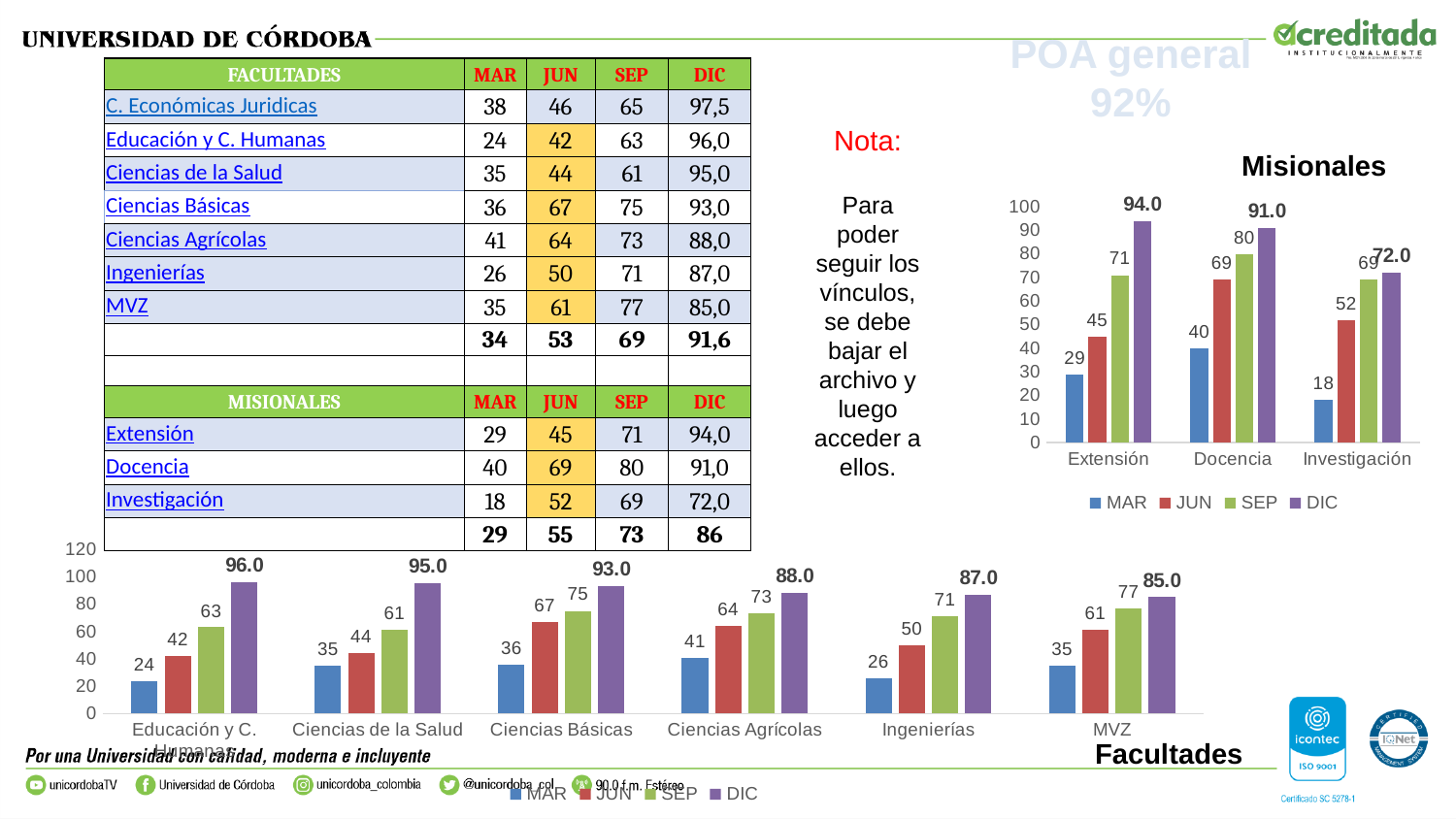
In the Misionales chart, which category has the lowest SEP value? Investigación In the Facultades chart, which category has the lowest MAR value? Educación y C. Humanas In the Misionales chart, what is the MAR value for Investigación? 18 In the Facultades chart, is the SEP value for MVZ larger or the SEP value for Ingenierías? MVZ In the Facultades chart, what is the JUN value for Ciencias Básicas? 67 In the Facultades chart, how many categories are shown on the x axis? 6 In the Misionales chart, what is the DIC value for Extensión? 94.0 In the Misionales chart, what is the difference between the SEP and JUN values for Docencia? 11 In the Facultades chart, which category has the highest DIC value? Educación y C. Humanas In the Misionales chart, how many series does the legend list? 4 In the Facultades chart, what is the difference between the DIC and MAR values for Ingenierías? 61 What kind of chart is the Facultades chart? Bar chart